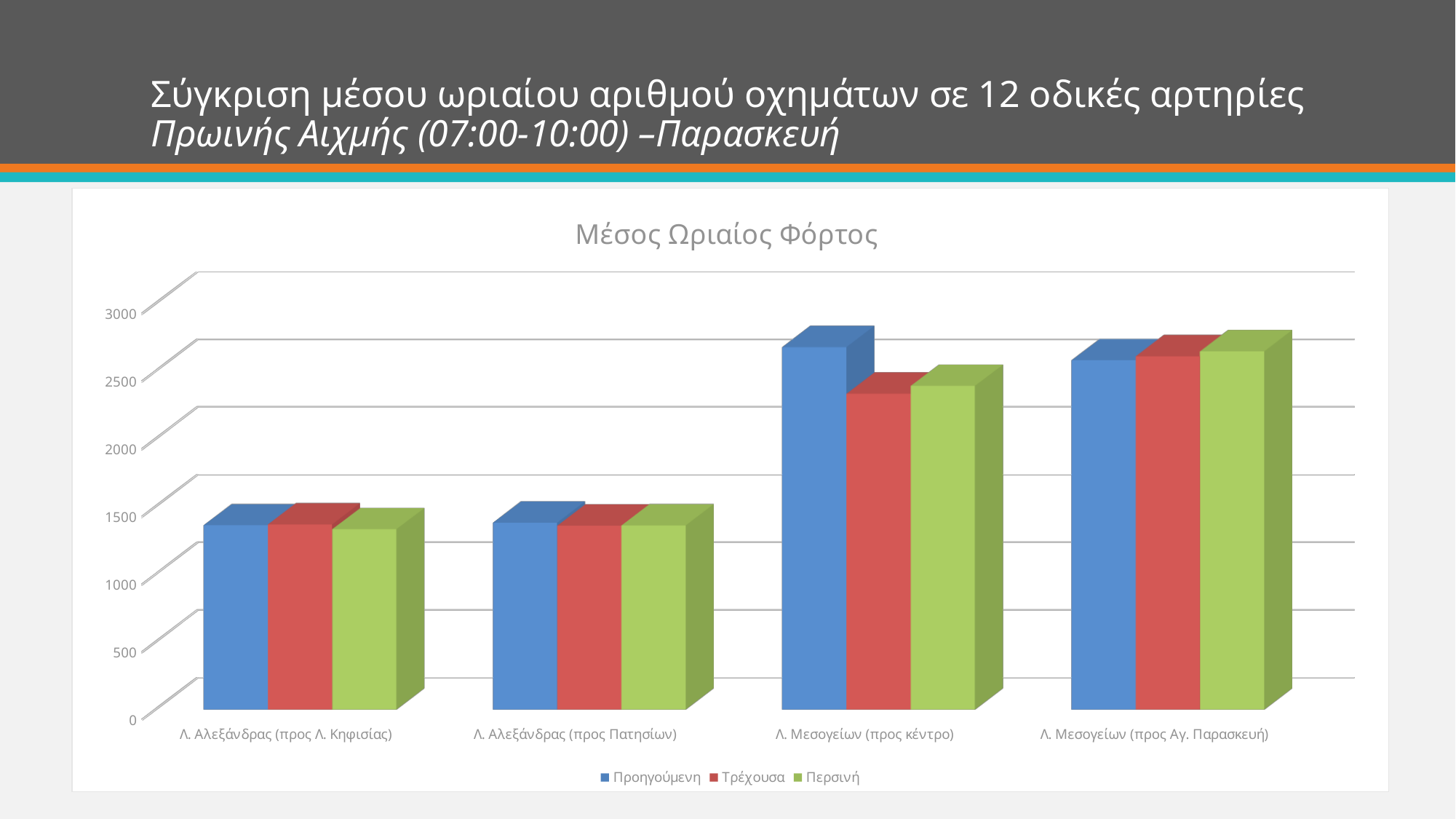
How many series does the legend list? 3 Which series is shown in red in the legend? Τρέχουσα Is the Προηγούμενη value for Λ. Μεσογείων (προς κέντρο) greater or less than 2500? greater Which category has the highest Τρέχουσα value? Λ. Μεσογείων (προς Αγ. Παρασκευή) Is the Τρέχουσα value for Λ. Μεσογείων (προς κέντρο) greater or less than 2500? less Is the Προηγούμενη value for Λ. Αλεξάνδρας (προς Λ. Κηφισίας) greater or less than 1500? less For Λ. Μεσογείων (προς κέντρο), which is larger: the Προηγούμενη value or the Τρέχουσα value? Προηγούμενη What is the title of the chart? Μέσος Ωριαίος Φόρτος For the Τρέχουσα series, which is larger: Λ. Μεσογείων (προς κέντρο) or Λ. Μεσογείων (προς Αγ. Παρασκευή)? Λ. Μεσογείων (προς Αγ. Παρασκευή) What kind of chart is shown on the slide? Bar chart How many road categories are shown on the x axis? 4